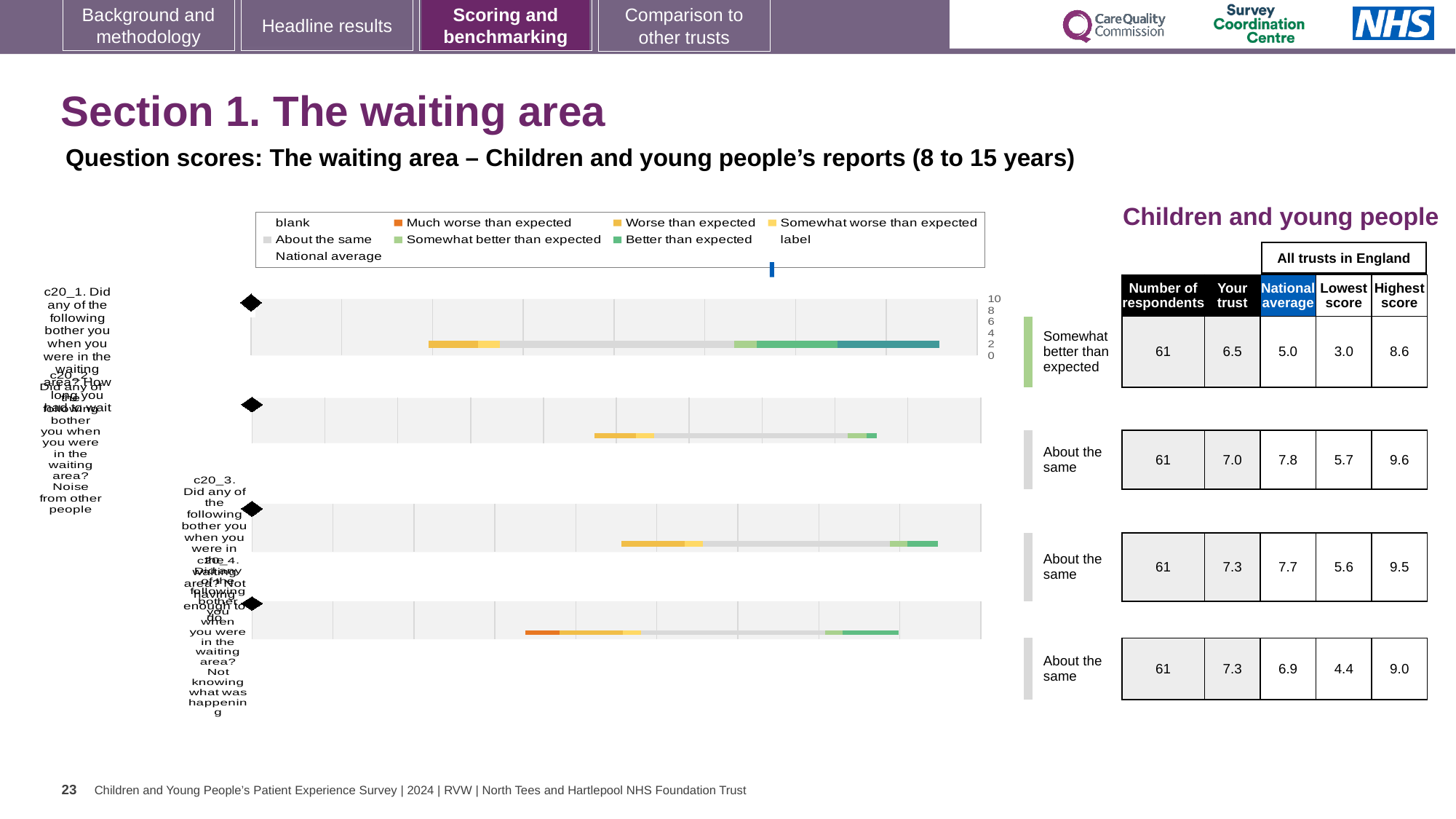
In the table beside the chart, which row has the lowest "Lowest score" value? the first row (3.0) In the table beside the chart, what is the "Your trust" score for the first row? 6.5 What kind of chart is shown on the slide? bar chart In the table beside the chart, what is the number of respondents for the first row? 61 What colour does the legend use for "Much worse than expected"? orange In the table beside the chart, which row has the highest "Highest score" value? the second row (9.6) How many entries does the chart legend list? 9 In the table beside the chart, what is the difference between the "Your trust" score and the national average for the first row? 1.5 How many horizontal bars does the chart contain? 4 In the table beside the chart, for the first row, which is larger: the "Your trust" score or the national average? Your trust Which benchmark category label is shown next to the first (top) bar? Somewhat better than expected In the table beside the chart, what is the national average for the first row? 5.0